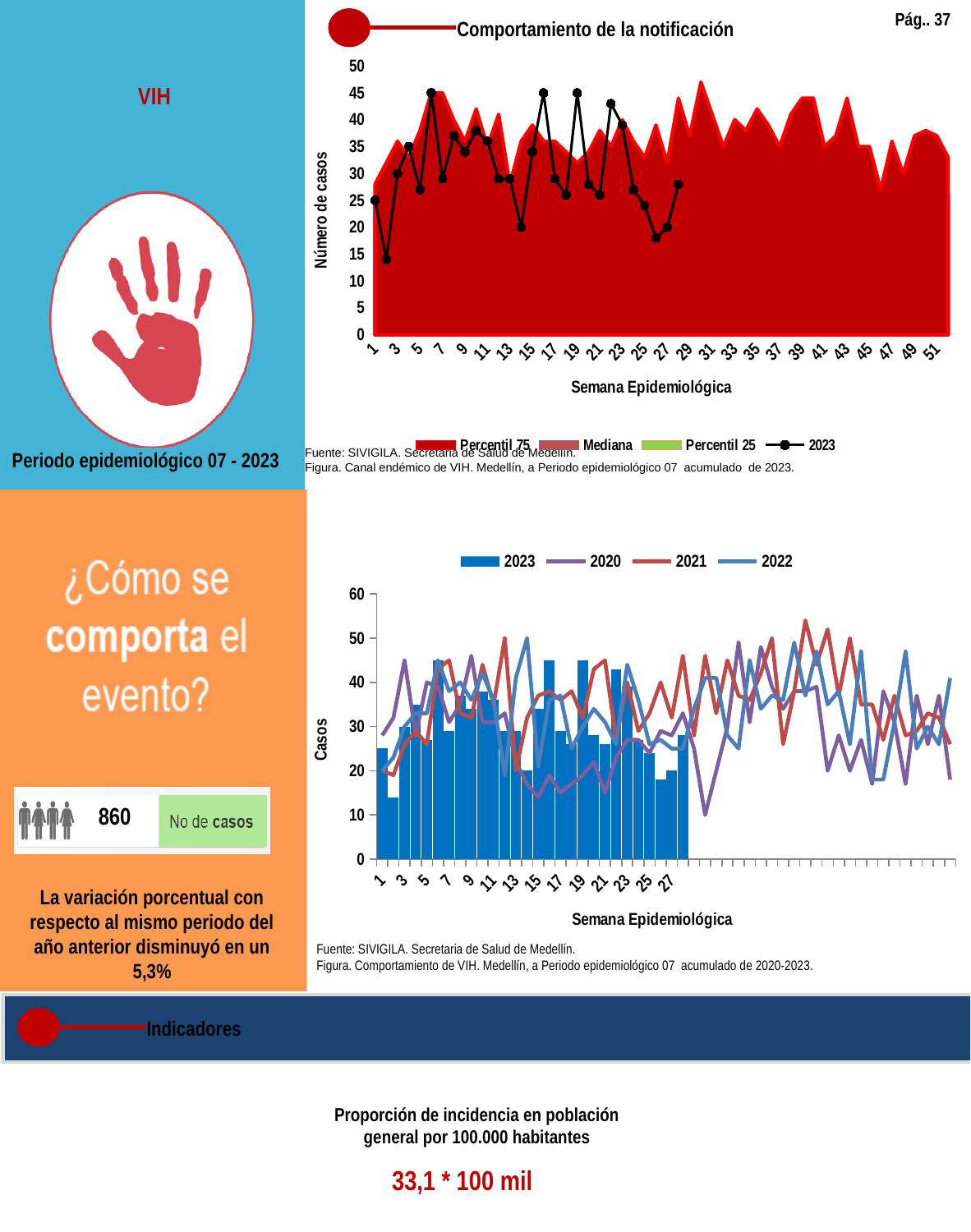
In the top chart, is the 2023 value for week 2 greater or less than 20? less In the bottom chart, how many weeks have a 2023 bar? 28 In the bottom chart, which is larger for 2023: week 1 or week 2? Week 1 What is the title of the top chart? Comportamiento de la notificación In the bottom chart, is the 2023 value for week 16 greater or less than 40? greater In the top chart, how many series does the legend list? 4 In the top chart, what kind of chart is the 2023 series drawn as? line chart In the bottom chart, how many series does the legend list? 4 In the bottom chart, is the 2023 value for week 2 greater or less than 20? less In the bottom chart, what kind of chart is the 2023 series drawn as? bar chart In the top chart, which week has the lowest 2023 value? Week 2